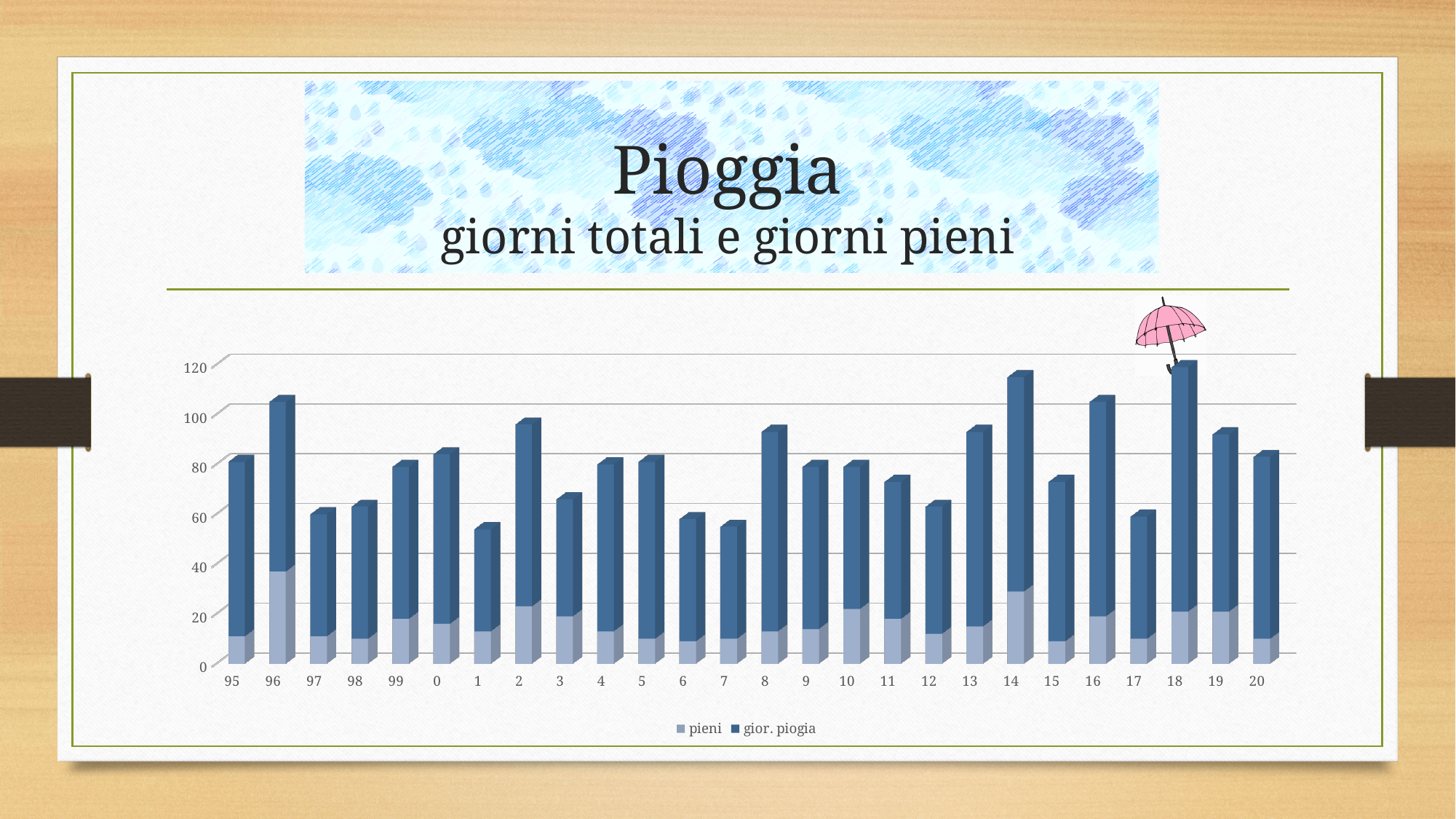
Is the total stacked bar for 97 greater or less than 80? less How many series does the legend list? 2 Which has the taller stacked bar, 14 or 15? 14 Is the total stacked bar for 14 greater or less than 100? greater What are the two series named in the legend? pieni and gior. piogia Which has the taller stacked bar, 96 or 97? 96 How many categories are shown along the x axis? 26 Is the total stacked bar for 17 greater or less than 80? less Which category has the tallest stacked bar overall? 18 Which category has the largest 'pieni' segment? 96 What kind of chart is shown on the slide? bar chart